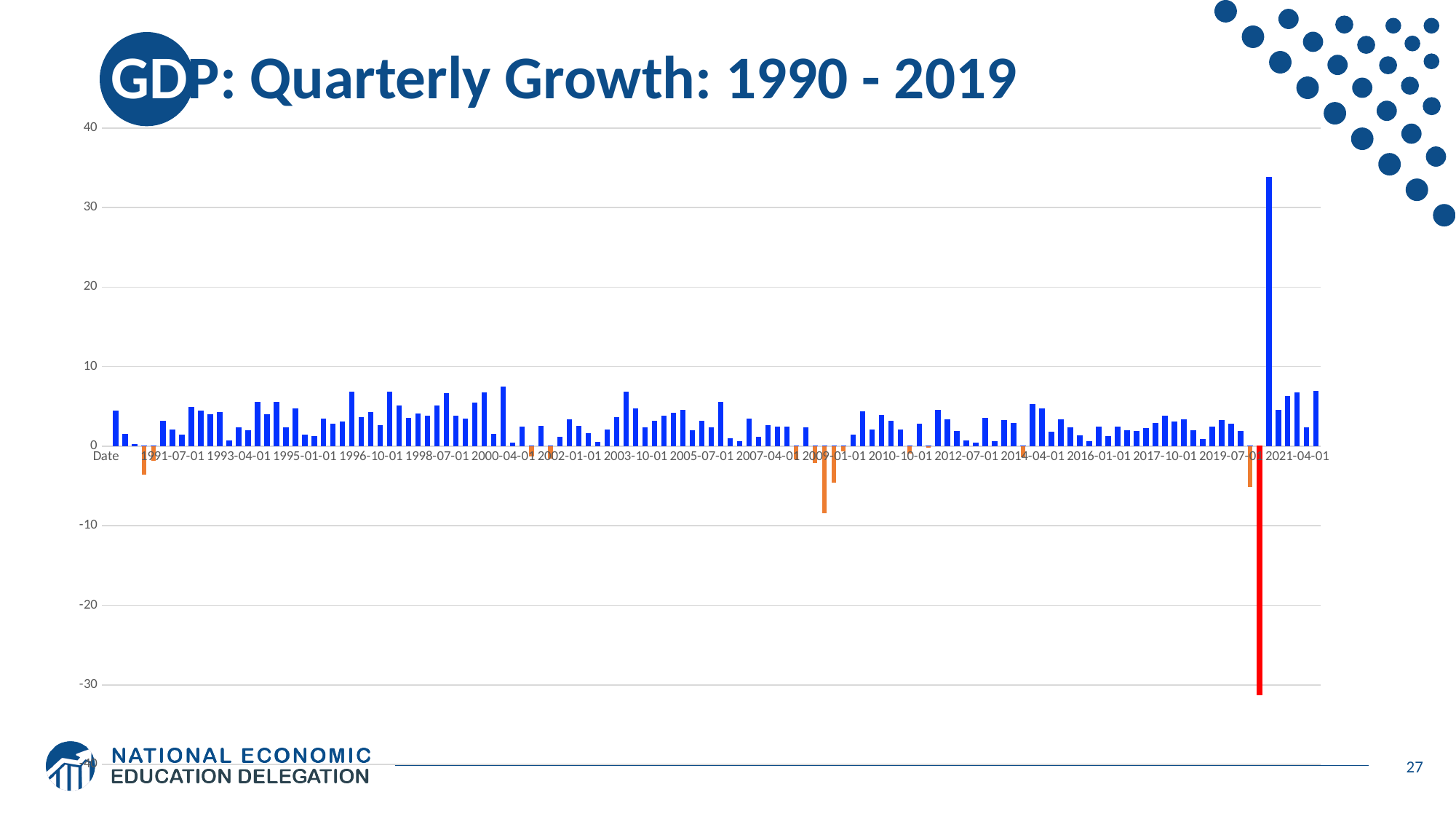
What is the highest value shown on the vertical axis of the chart? 40 Is the highest bar on the chart located before or after the 2019-07-01 axis label? after What is the title of the chart on the slide? GDP: Quarterly Growth: 1990 - 2019 Which is larger in magnitude: the tallest blue bar or the red bar? the tallest blue bar Is the value of the red bar on the chart greater or less than -30? less Which colour is used for the bar with the lowest value on the chart? red Is the value of the bar at 1991-07-01 greater or less than 0? greater Is the lowest bar on the chart located before or after the 2019-07-01 axis label? after Is the value of the tallest bar on the chart greater or less than 30? greater What kind of chart is shown on the slide? bar chart